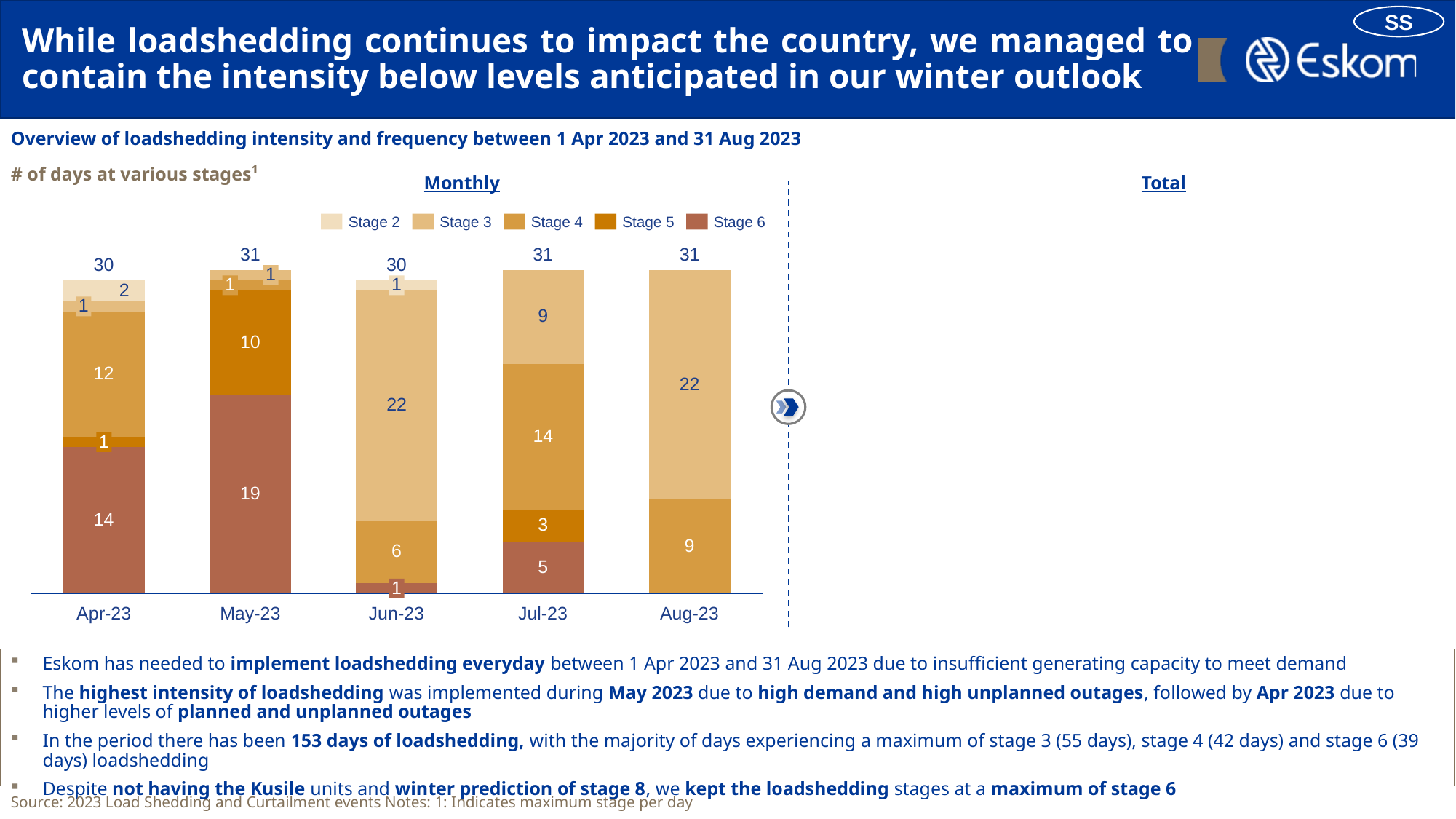
In the Monthly chart, which month has the highest number of Stage 6 days? May-23 How many months are shown on the x axis of the Monthly chart? 5 In the Monthly chart, how many Stage 3 days were there in Aug-23? 22 In the Monthly chart, which is larger: Stage 5 days in May-23 or Stage 5 days in Jul-23? May-23 In the Monthly chart, which month has the lowest number of Stage 4 days? May-23 How many series does the legend of the Monthly chart list? 5 In the Monthly chart, what is the total number of days shown for Jun-23? 30 In the Monthly chart, what is the difference between Stage 6 days in Apr-23 and Jul-23? 9 What type of chart is shown under the "Monthly" heading? Stacked bar chart In the Monthly chart, how many Stage 4 days were there in Jul-23? 14 Which stage is shown in the darkest (reddish-brown) colour in the Monthly chart legend? Stage 6 In the Monthly chart, how many Stage 6 days were there in May-23? 19